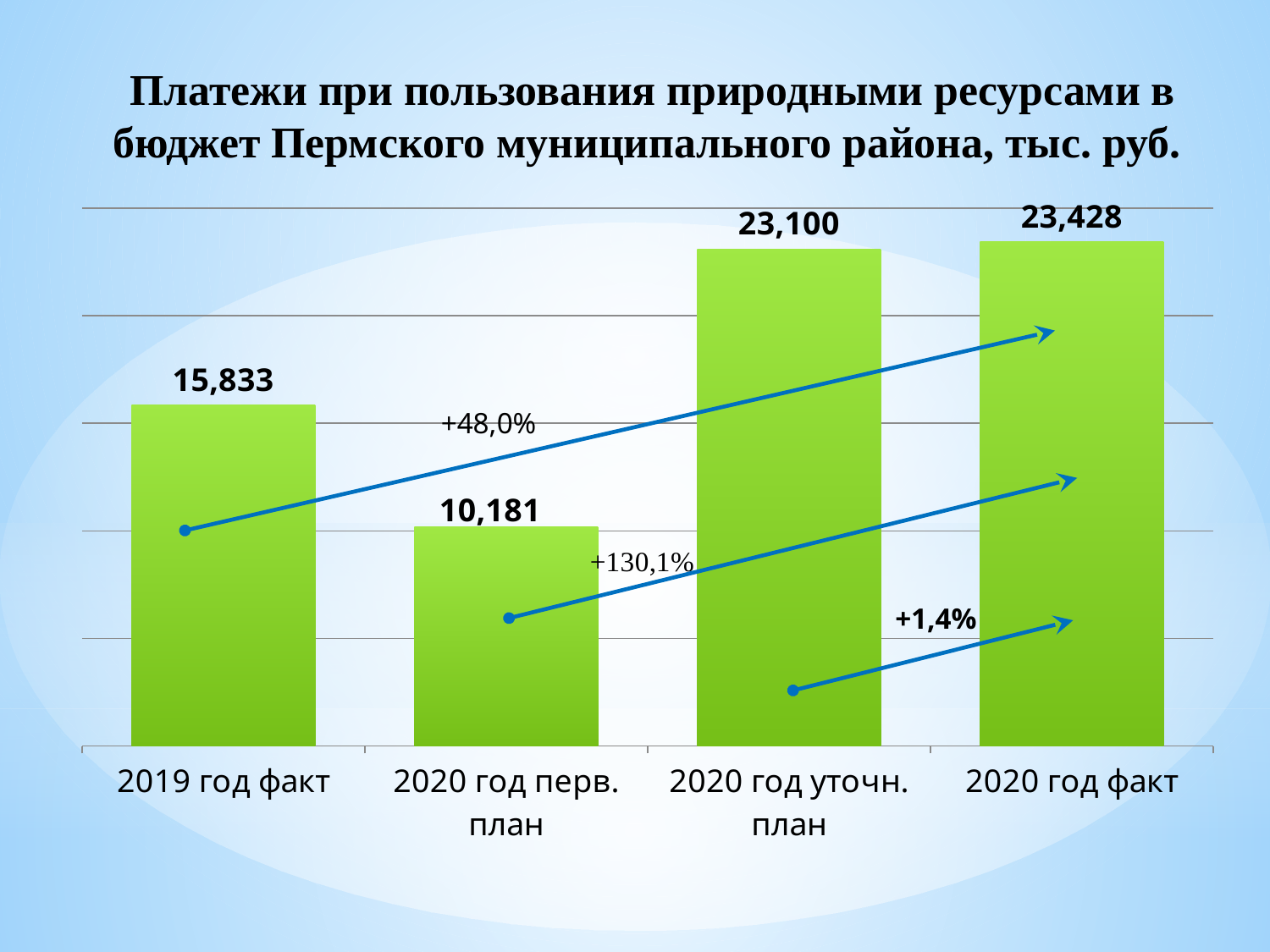
Which category has the lowest value? 2020 год перв. план What percentage change is shown on the arrow from 2020 год уточн. план to 2020 год факт? +1,4% How many categories are shown on the x axis? 4 What is the value for 2020 год перв. план? 10,181 What type of chart is shown on the slide? Bar chart Which category has the highest value? 2020 год факт Which is larger, the value for 2019 год факт or the value for 2020 год перв. план? 2019 год факт What is the difference between the values for 2020 год факт and 2020 год уточн. план? 328 What is the value for 2020 год факт? 23,428 What is the difference between the values for 2019 год факт and 2020 год перв. план? 5,652 What is the value for 2019 год факт? 15,833 What is the value for 2020 год уточн. план? 23,100